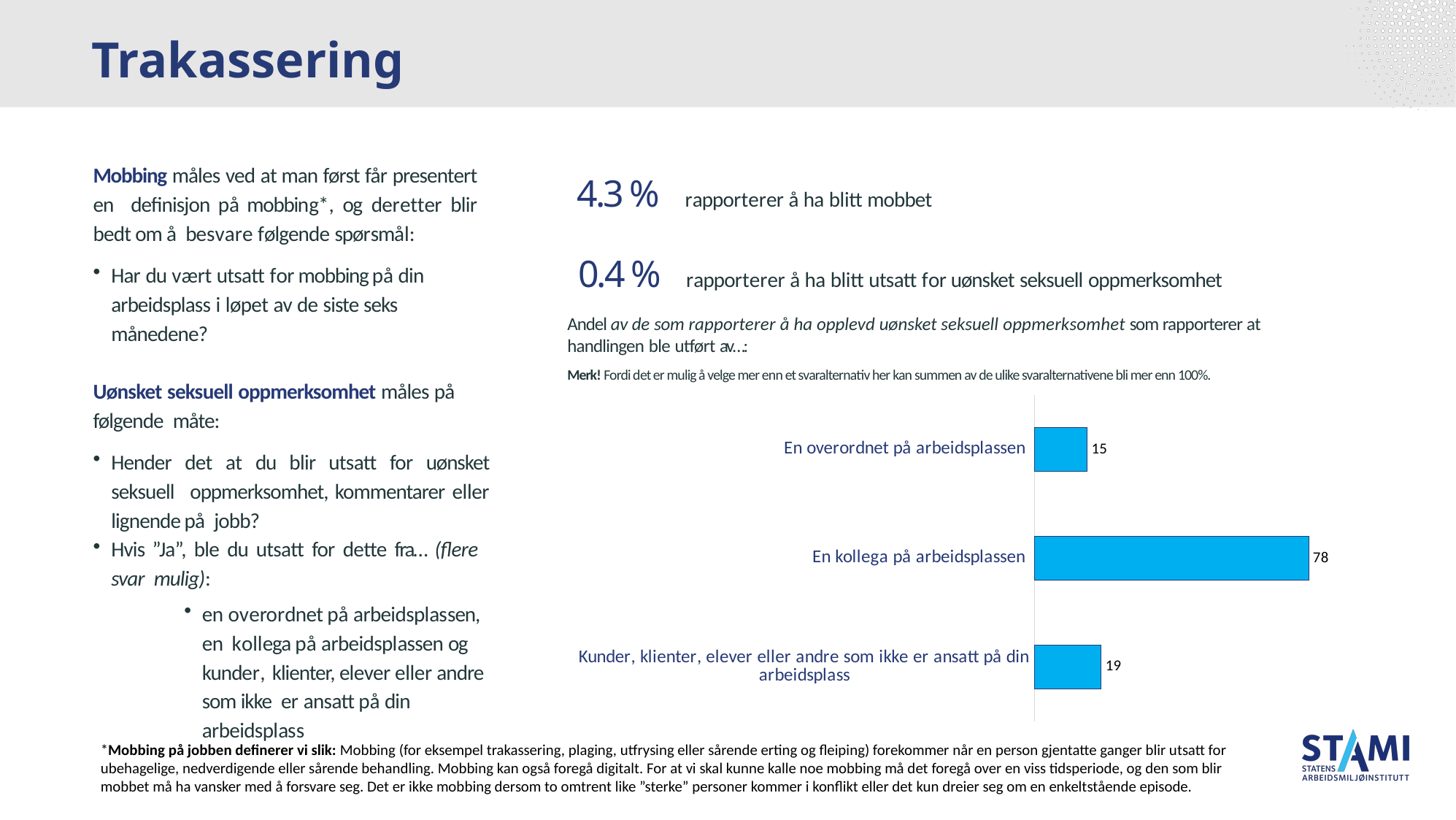
Which category has the highest value in the chart? En kollega på arbeidsplassen Are the bars in the chart horizontal or vertical? Horizontal What kind of chart is shown on the slide? Bar chart What value is shown for "En overordnet på arbeidsplassen"? 15 Which category has the lowest value in the chart? En overordnet på arbeidsplassen What is the difference between the values for "En kollega på arbeidsplassen" and "En overordnet på arbeidsplassen"? 63 What value is shown for "Kunder, klienter, elever eller andre som ikke er ansatt på din arbeidsplass"? 19 Which is larger: the value for "Kunder, klienter, elever eller andre som ikke er ansatt på din arbeidsplass" or the value for "En overordnet på arbeidsplassen"? Kunder, klienter, elever eller andre som ikke er ansatt på din arbeidsplass What value is shown for "En kollega på arbeidsplassen"? 78 What is the difference between the values for "Kunder, klienter, elever eller andre som ikke er ansatt på din arbeidsplass" and "En overordnet på arbeidsplassen"? 4 How many categories are shown in the chart? 3 What colour are the bars in the chart? Blue